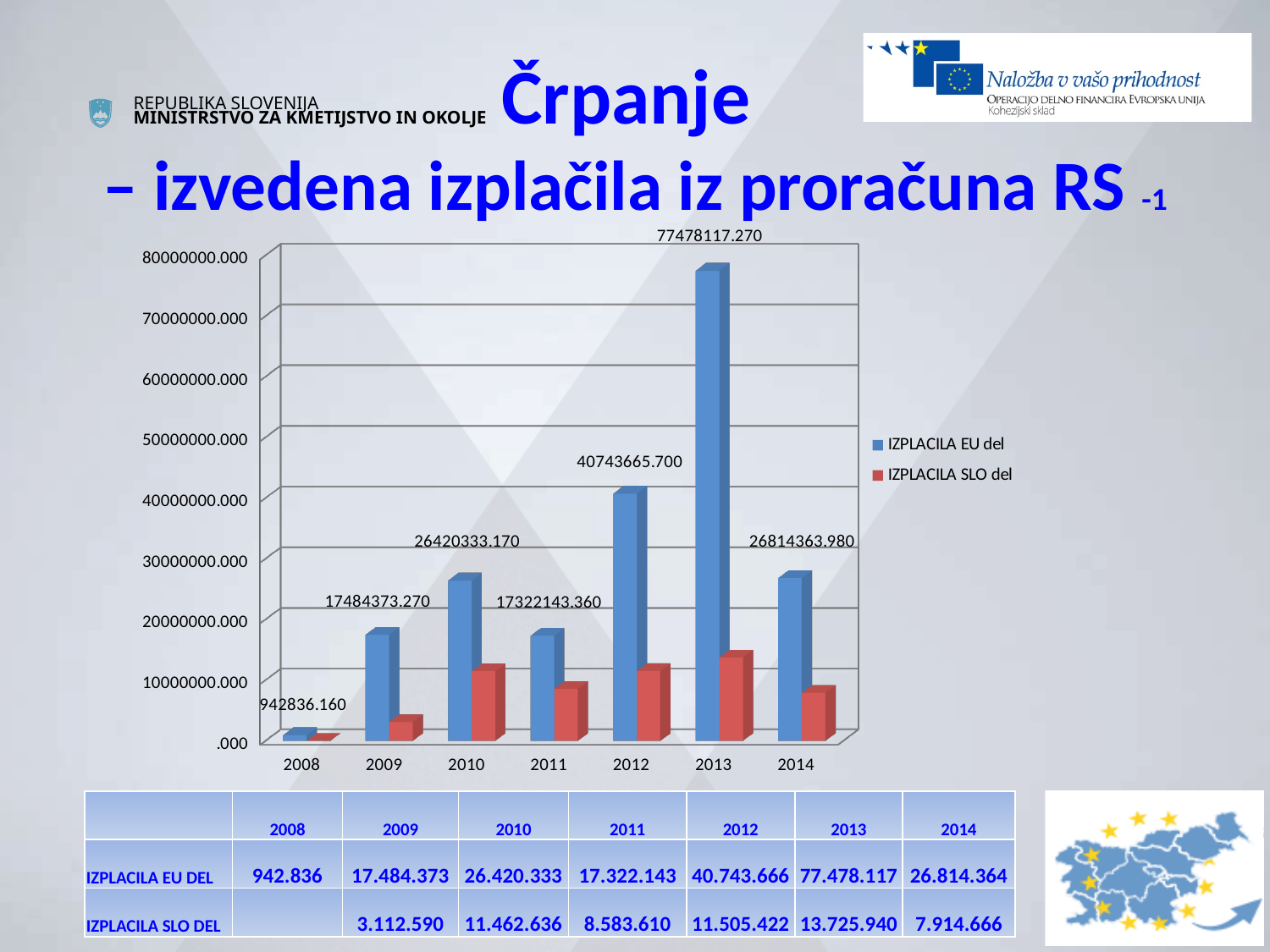
What is the value of IZPLACILA EU del for 2012 according to the data label on the chart? 40743665.700 Is the IZPLACILA SLO del value for 2009 greater or less than 10000000.000? less How many years are shown on the x axis of the chart? 7 Which is larger, the IZPLACILA EU del value for 2010 or for 2011? 2010 Which year has the highest IZPLACILA EU del value? 2013 Which year has the lowest IZPLACILA EU del value? 2008 How many series does the chart legend list? 2 What type of chart is shown on the slide? bar chart What is the value of IZPLACILA EU del for 2013 according to the data label on the chart? 77478117.270 What is the value of IZPLACILA EU del for 2008 according to the data label on the chart? 942836.160 Which legend entry is shown in blue on the chart? IZPLACILA EU del Is the IZPLACILA SLO del value for 2013 greater or less than 10000000.000? greater